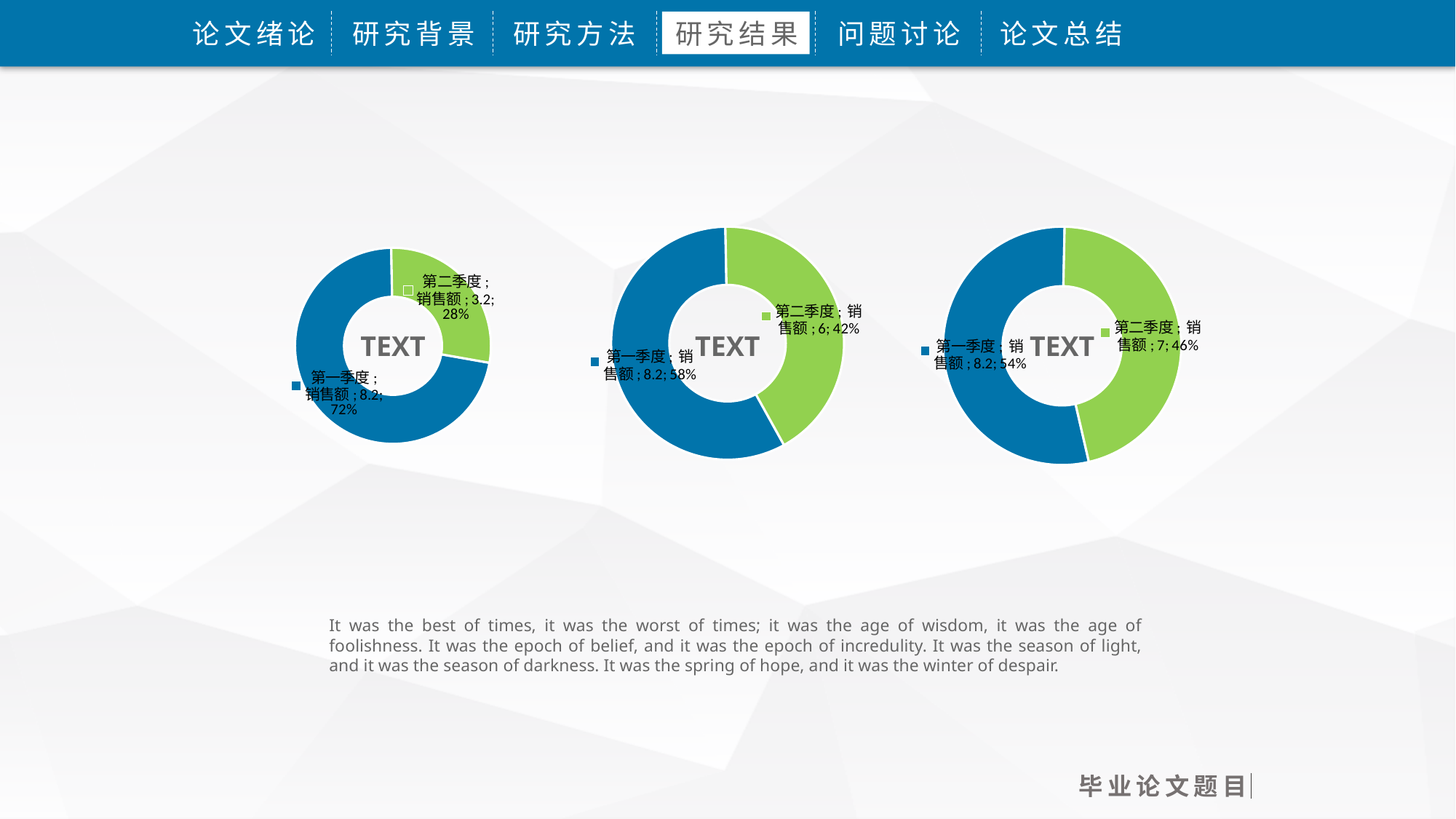
How many slices does the right chart have? 2 In the middle chart, what is the 销售额 value for 第二季度? 6 In the left chart, what is the 销售额 value for 第一季度? 8.2 In the middle chart, what percentage share does 第一季度 have? 58% In the middle chart, which is larger, the 第一季度 value or the 第二季度 value? 第一季度 In the left chart, which category has the largest slice? 第一季度 In the right chart, which category has the smallest slice? 第二季度 In the right chart, what is the 销售额 value for 第二季度? 7 In the right chart, what percentage share does 第二季度 have? 46% What type of chart is shown in the middle of the slide? Doughnut chart In the left chart, what percentage share does 第二季度 have? 28% In the left chart, what is the difference between the 第一季度 and 第二季度 销售额 values? 5